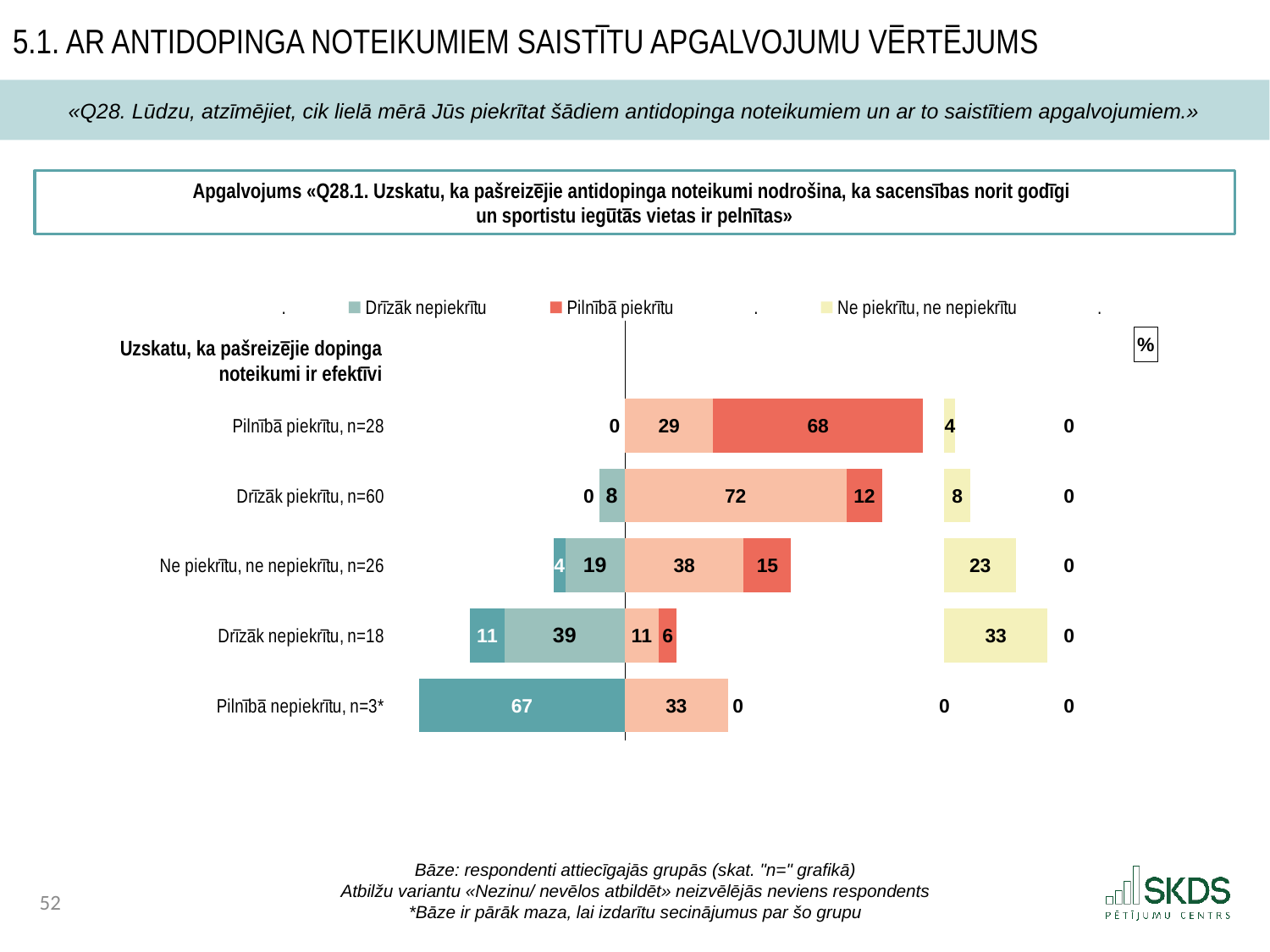
Which row has the larger 'Drīzāk nepiekrītu' value: 'Ne piekrītu, ne nepiekrītu, n=26' or 'Drīzāk nepiekrītu, n=18'? Drīzāk nepiekrītu, n=18 What is the 'Pilnībā piekrītu' value for the row 'Drīzāk piekrītu, n=60'? 12 What colour are the 'Pilnībā piekrītu' bar segments? red What is the 'Ne piekrītu, ne nepiekrītu' value for the row 'Ne piekrītu, ne nepiekrītu, n=26'? 23 What is the difference between the 'Pilnībā piekrītu' values for 'Pilnībā piekrītu, n=28' and 'Drīzāk piekrītu, n=60'? 56 Which row has the highest 'Ne piekrītu, ne nepiekrītu' value? Drīzāk nepiekrītu, n=18 How many respondent group rows are plotted in the chart? 5 Which row has the highest 'Pilnībā piekrītu' value? Pilnībā piekrītu, n=28 What is the 'Drīzāk nepiekrītu' value for the row 'Drīzāk nepiekrītu, n=18'? 39 What type of chart is shown on the slide? bar chart What is the 'Pilnībā piekrītu' value for the row 'Pilnībā piekrītu, n=28'? 68 What is the difference between the 'Ne piekrītu, ne nepiekrītu' values for 'Drīzāk nepiekrītu, n=18' and 'Ne piekrītu, ne nepiekrītu, n=26'? 10